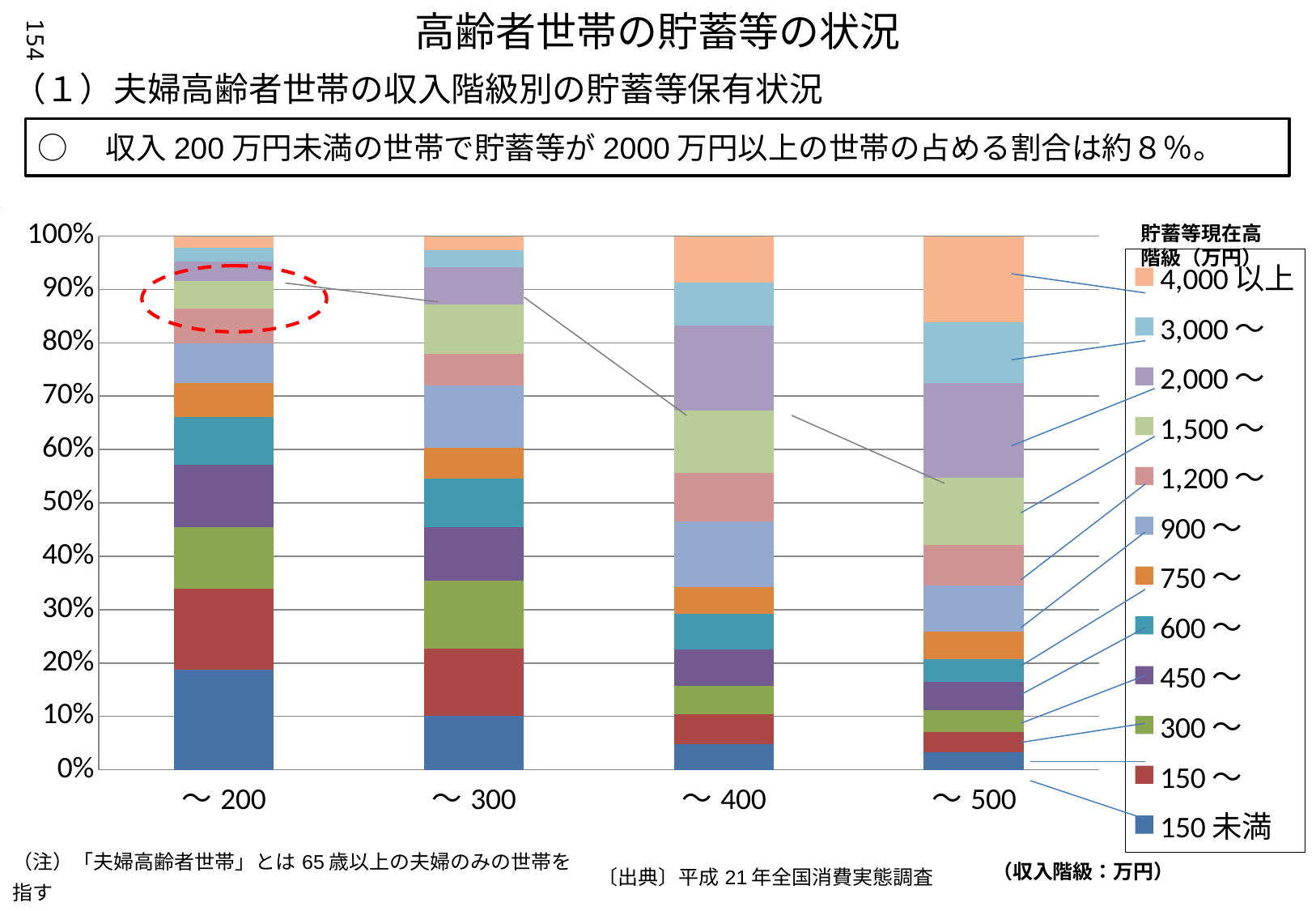
Which income class has a larger share of 4,000以上 households, ～200 or ～500? ～500 Which income class has the smallest share of households with savings of 150未満? ～500 How many series does the legend list? 12 Is the share of 150未満 households in the ～500 income class greater or less than 10%? less Which income class has the largest share of households with savings of 150未満? ～200 How many income-class categories are plotted along the x axis? 4 Is the share of 150未満 households in the ～200 income class greater or less than 10%? greater Which income class has the largest share of households with savings of 4,000以上? ～500 As income class rises from ～200 to ～500, does the share of 150未満 households rise or fall? Fall What is the title of the legend? 貯蓄等現在高階級（万円） What kind of chart is shown on the slide? Stacked bar chart What is the label shown under the x axis for the income classes? （収入階級：万円）